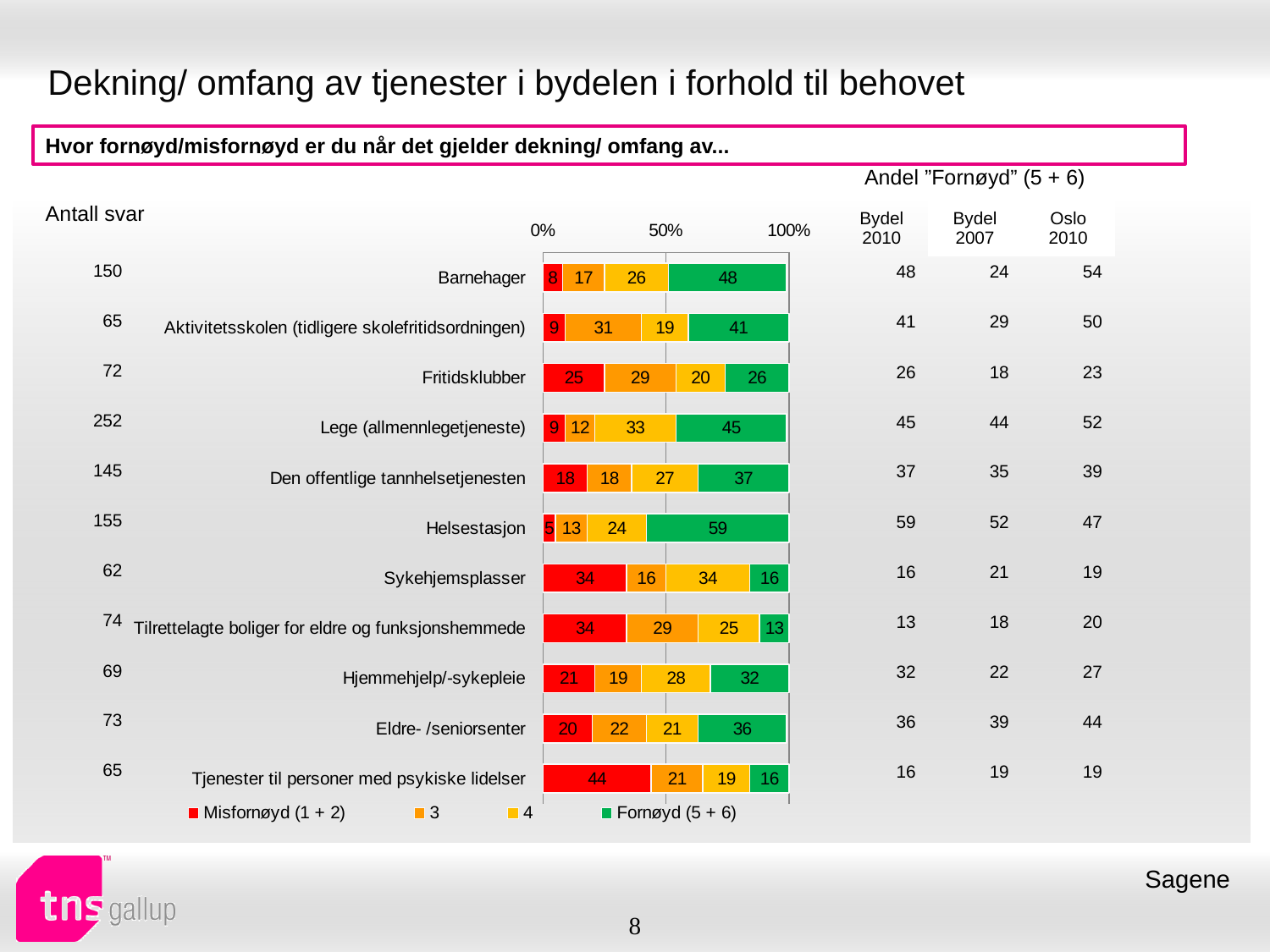
What is the value of the Misfornøyd (1 + 2) segment for Fritidsklubber? 25 What is the total of the stacked bar for Fritidsklubber? 100 How many series does the legend list? 4 Which category has the highest Misfornøyd (1 + 2) value? Tjenester til personer med psykiske lidelser What is the value of the Fornøyd (5 + 6) segment for Barnehager? 48 Which category has the highest Fornøyd (5 + 6) value? Helsestasjon Which has a larger Fornøyd (5 + 6) value, Eldre- /seniorsenter or Hjemmehjelp/-sykepleie? Eldre- /seniorsenter What kind of chart is shown on the slide? Stacked bar chart What is the value of the '4' segment for Lege (allmennlegetjeneste)? 33 How many categories are shown in the chart? 11 Which category has the lowest Fornøyd (5 + 6) value? Tilrettelagte boliger for eldre og funksjonshemmede What is the difference between the Fornøyd (5 + 6) values for Helsestasjon and Sykehjemsplasser? 43